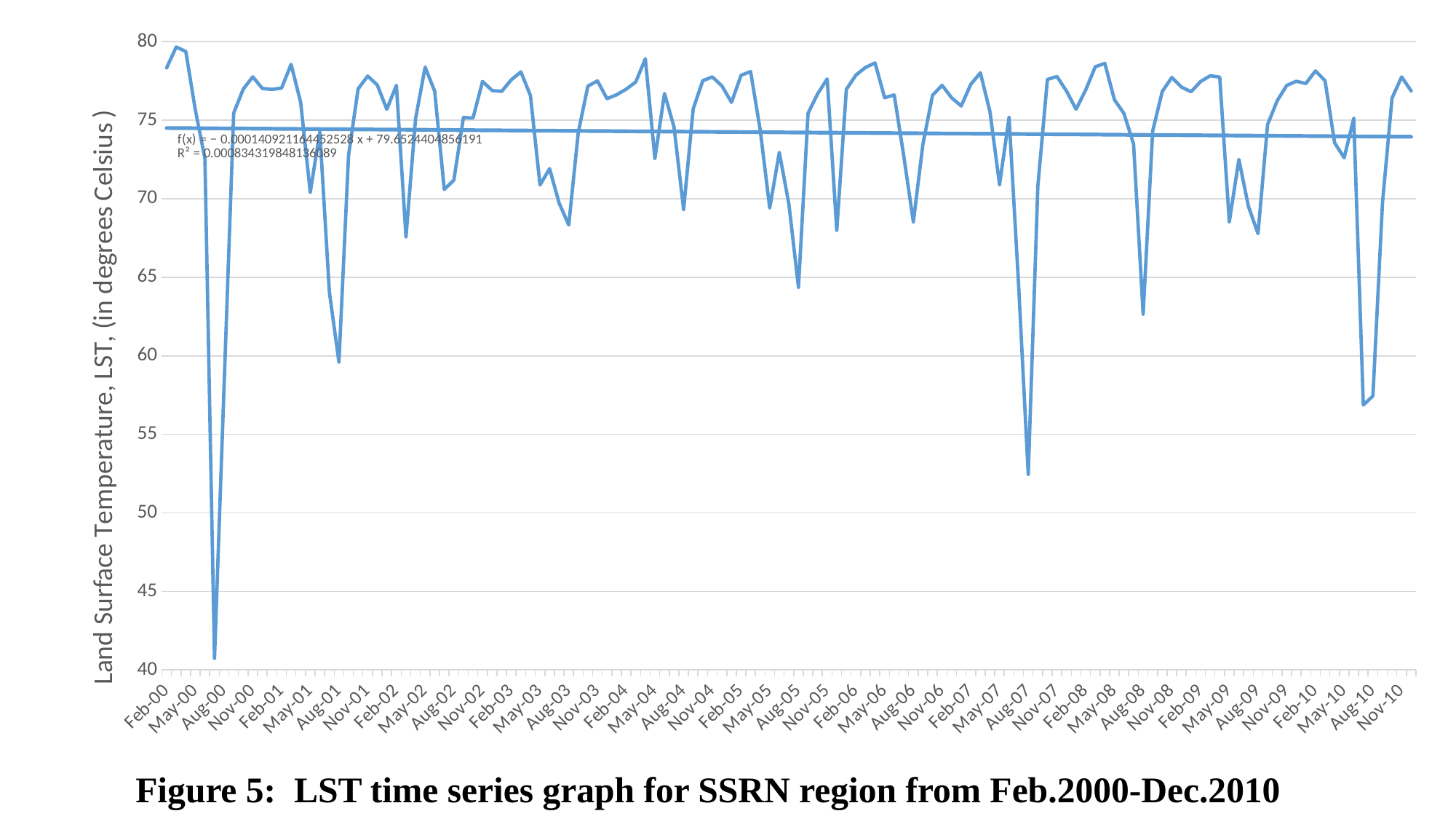
What kind of chart is shown on the slide? line chart Is the value for Aug-10 greater or less than 60? less Is the value for Aug-05 greater or less than 70? less Is the value for Feb-00 greater or less than 75? greater What is the title of the figure shown on the slide? Figure 5: LST time series graph for SSRN region from Feb.2000-Dec.2010 What is the label of the vertical axis? Land Surface Temperature, LST, (in degrees Celsius ) Does the fitted trend line rise or fall from left to right across the x axis? fall